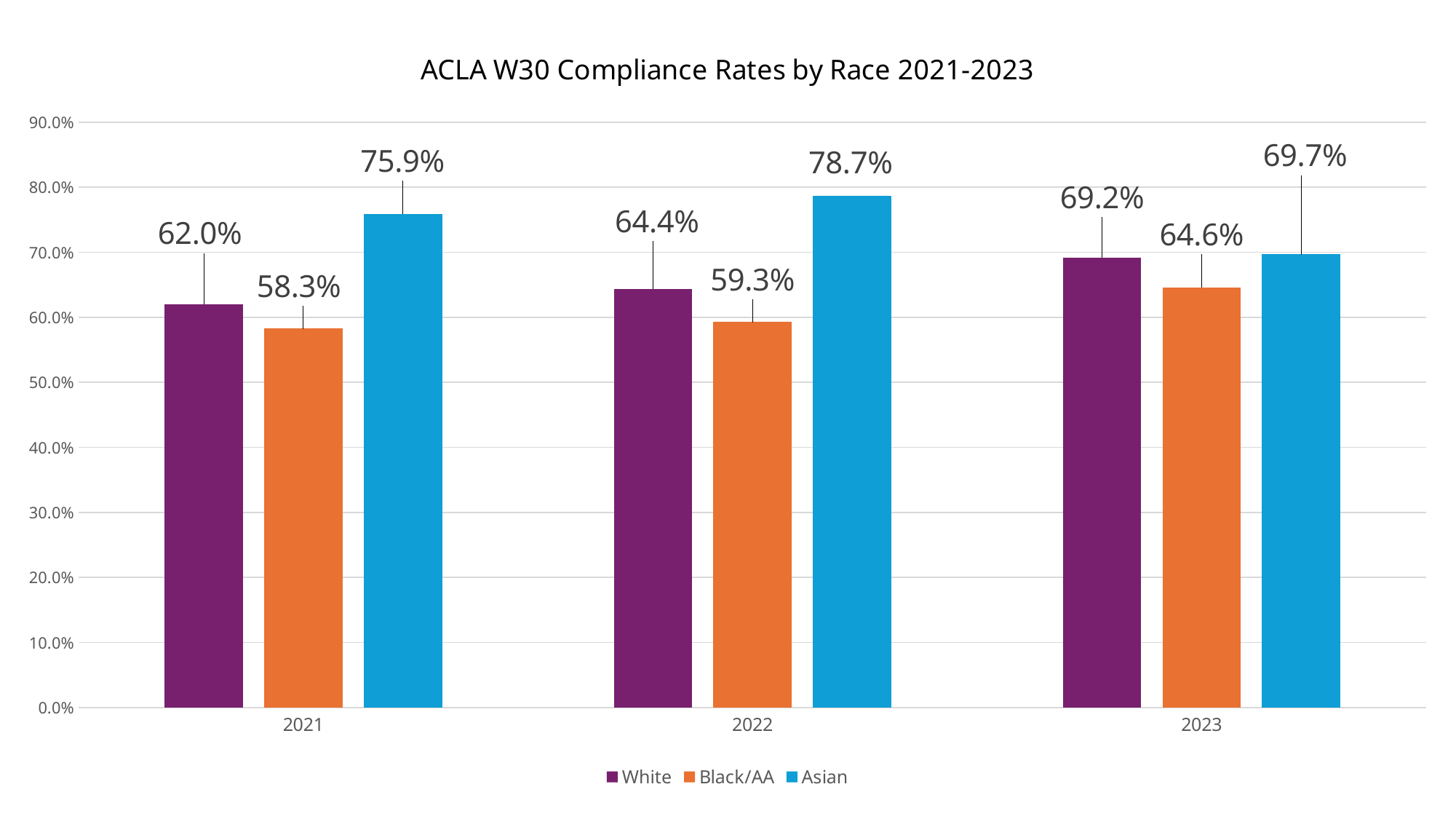
Is the compliance rate for Black/AA in 2023 greater or less than 60.0%? greater Which year has the highest compliance rate for Asian? 2022 How many series does the legend list? 3 How many years are shown on the x axis? 3 What is the compliance rate for Black/AA in 2021? 58.3% Which race has the lowest compliance rate in 2022? Black/AA What is the difference between the Asian and White compliance rates in 2021? 13.9% What is the compliance rate for White in 2023? 69.2% What kind of chart is shown on the slide? Bar chart What is the compliance rate for Asian in 2022? 78.7% Does the compliance rate for White rise or fall from 2021 to 2023? Rise Which is larger in 2023, the compliance rate for White or for Asian? Asian